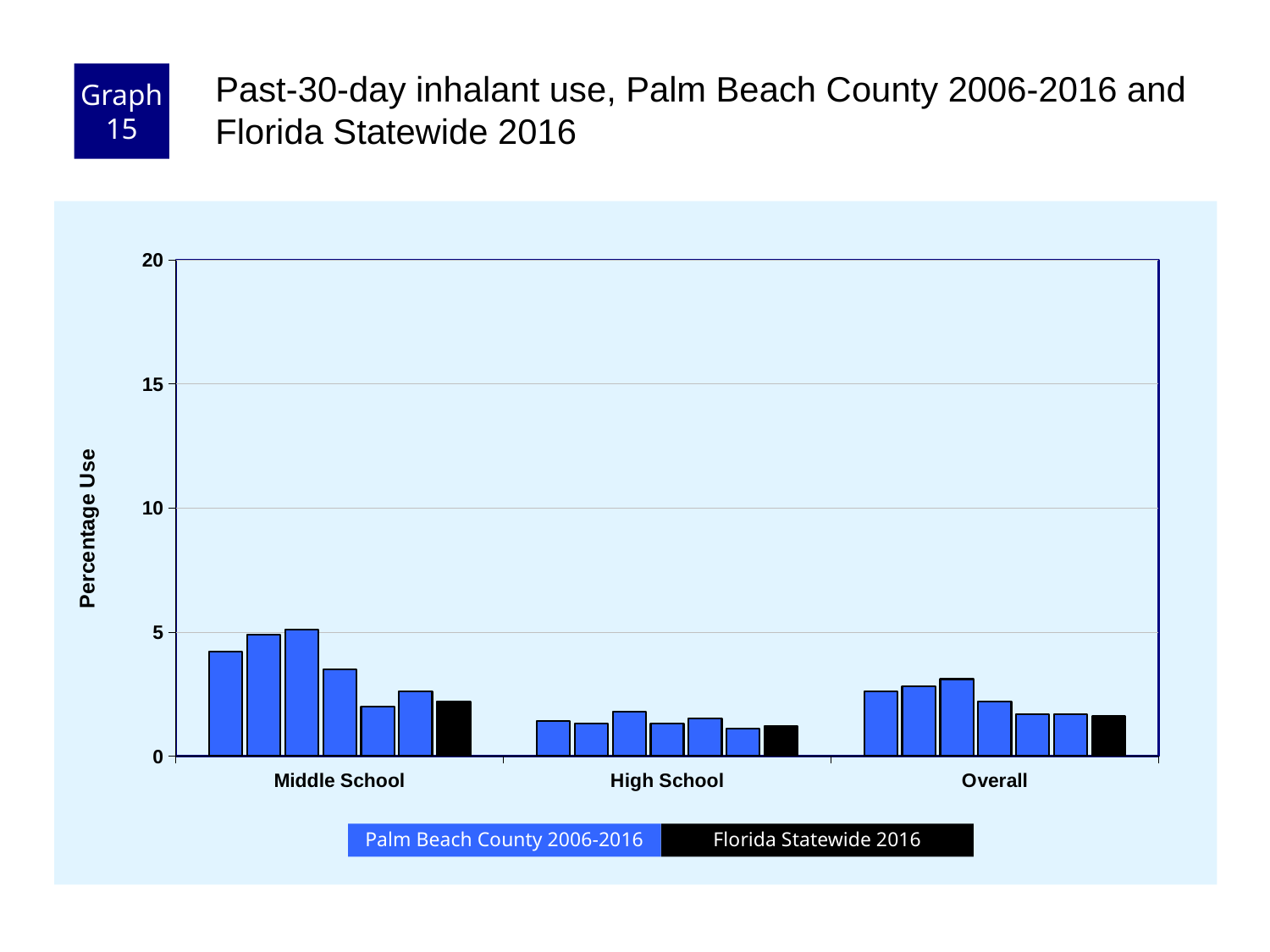
Is the first Palm Beach County bar for Middle School greater or less than 5? less How many series does the legend list? 2 How many school-level categories are shown on the x axis? 3 Which category group has the lowest bars overall? High School What colour represents Florida Statewide 2016 in the legend? black What kind of chart is shown on the slide? bar chart Which category group contains the tallest bar? Middle School Is the Florida Statewide 2016 value for Overall greater or less than 5? less What is the label on the y axis? Percentage Use Which is larger: the Florida Statewide 2016 bar for Middle School or the Florida Statewide 2016 bar for High School? Middle School Are any bars in the High School group greater than 10? No